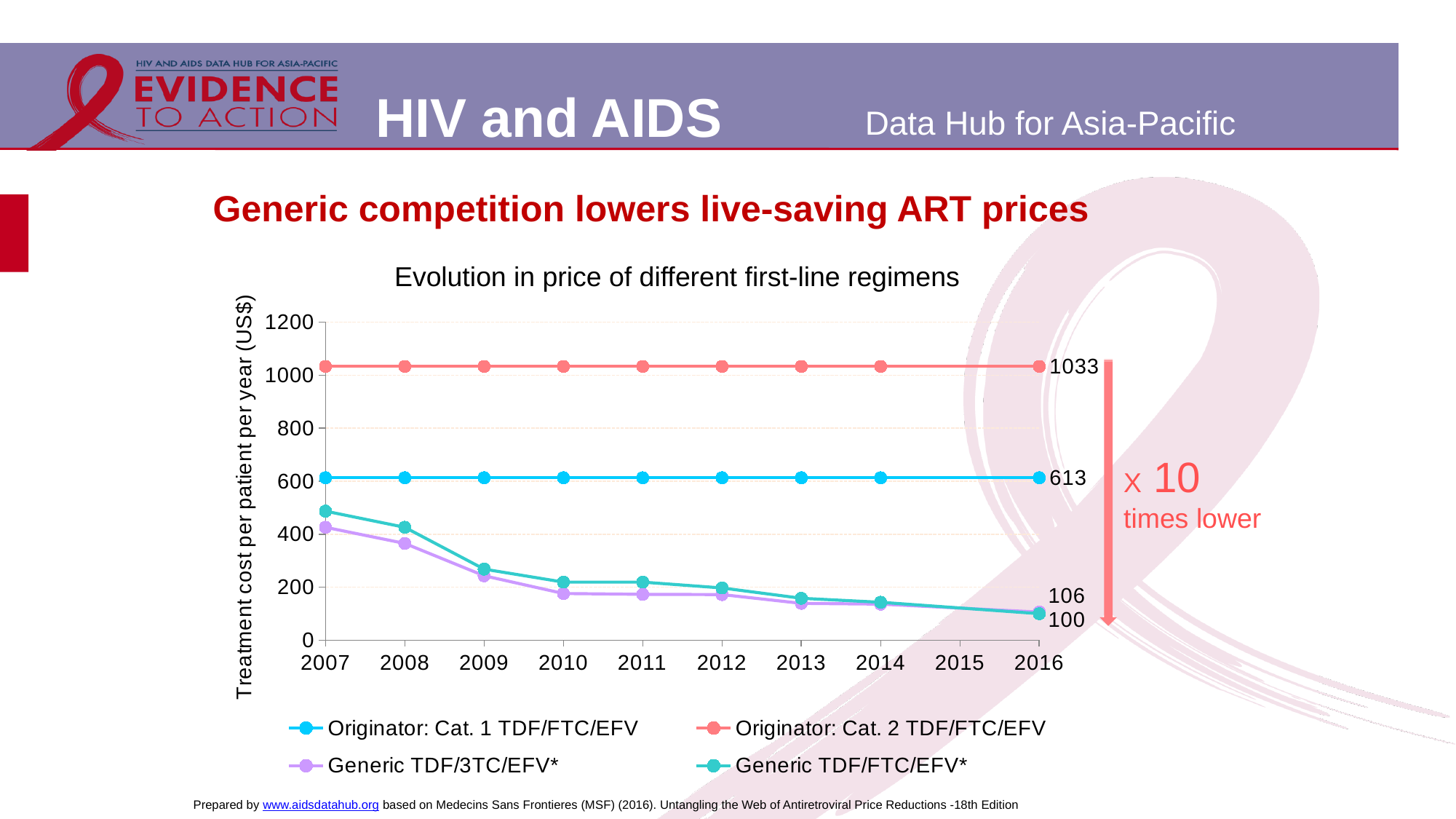
Is the value for Generic TDF/FTC/EFV* in 2007 greater or less than 400? greater Does the value for Generic TDF/FTC/EFV* rise or fall from 2007 to 2016? Fall Which is larger in 2016: Originator: Cat. 1 TDF/FTC/EFV or Originator: Cat. 2 TDF/FTC/EFV? Originator: Cat. 2 TDF/FTC/EFV Is the value for Generic TDF/3TC/EFV* in 2013 greater or less than 200? less Which series has the highest value in 2016? Originator: Cat. 2 TDF/FTC/EFV What is the 2016 value for Originator: Cat. 2 TDF/FTC/EFV? 1033 What is the difference between the 2016 values of Originator: Cat. 2 TDF/FTC/EFV and Originator: Cat. 1 TDF/FTC/EFV? 420 What is the 2016 value for Originator: Cat. 1 TDF/FTC/EFV? 613 How many series does the legend list? 4 What is the title of the chart? Evolution in price of different first-line regimens How many years are shown on the x axis? 10 What kind of chart is shown on the slide? Line chart